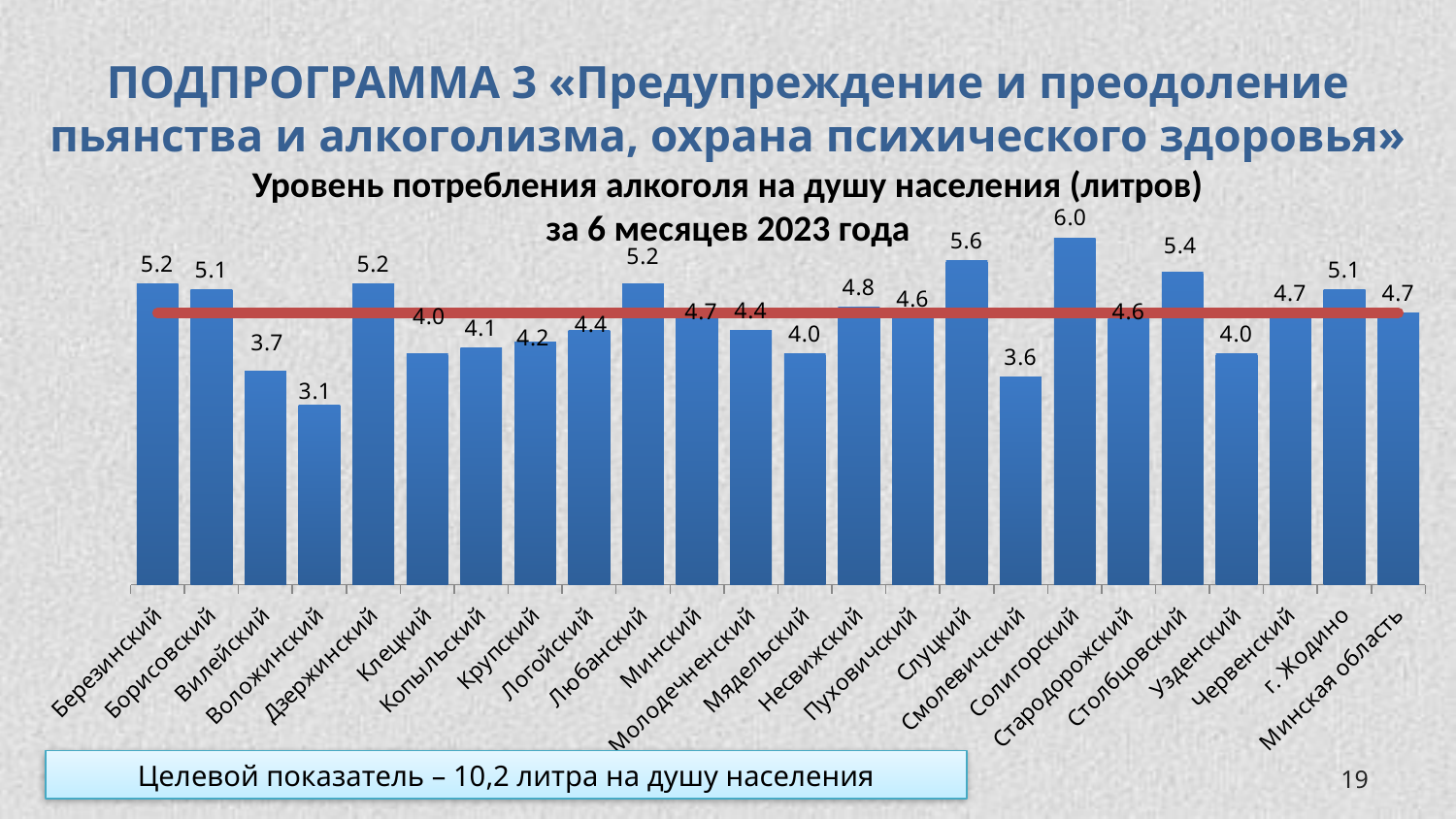
What is the title of the chart? Уровень потребления алкоголя на душу населения (литров) за 6 месяцев 2023 года Which category has the highest value? Солигорский What is the value for Солигорский? 6.0 What kind of chart is this? bar chart Which category has the lowest value? Воложинский What is the value for Смолевичский? 3.6 What is the value for Минская область? 4.7 What is the difference between the values for Слуцкий and Столбцовский? 0.2 What is the difference between the values for Солигорский and Воложинский? 2.9 How many categories are shown on the x axis? 24 Which is larger, the value for Вилейский or the value for Несвижский? Несвижский What is the value for Воложинский? 3.1